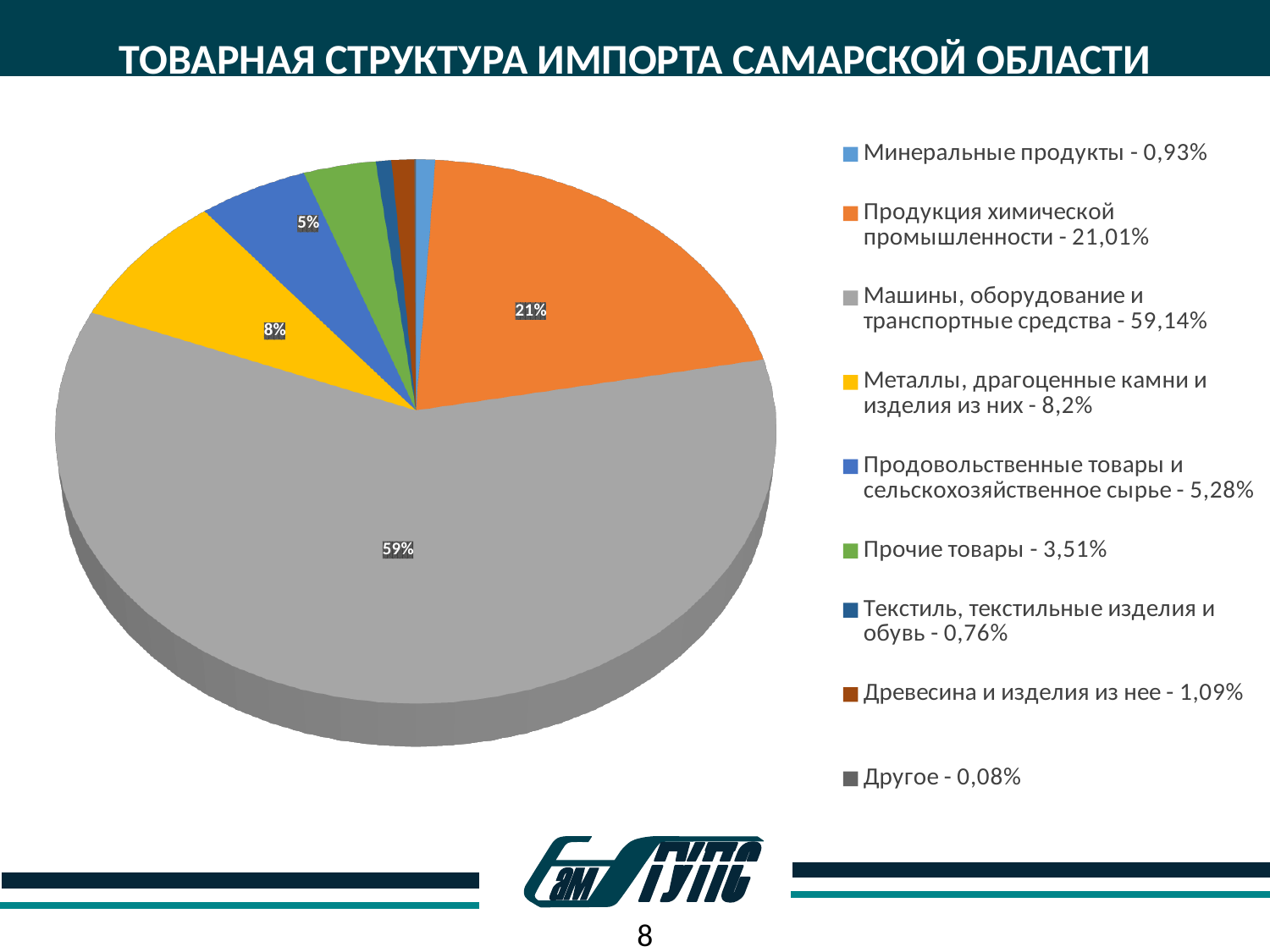
What share of imports does the legend give for Древесина и изделия из нее? 1,09% Which category has the smallest share of imports according to the legend? Другое What share of imports does the legend give for Металлы, драгоценные камни и изделия из них? 8,2% What data label is printed on the largest slice of the pie? 59% By how many percentage points does the share of Машины, оборудование и транспортные средства exceed that of Продукция химической промышленности, using the legend values? 38,13% What is the title of the slide containing the pie chart? ТОВАРНАЯ СТРУКТУРА ИМПОРТА САМАРСКОЙ ОБЛАСТИ Which category has the largest share of imports in the pie chart? Машины, оборудование и транспортные средства How many categories does the legend of the pie chart list? 9 Which has the larger share: Минеральные продукты or Текстиль, текстильные изделия и обувь? Минеральные продукты What kind of chart is shown on the slide? pie chart What share of imports does the legend give for Продукция химической промышленности? 21,01% Which has the larger share: Продовольственные товары и сельскохозяйственное сырье or Прочие товары? Продовольственные товары и сельскохозяйственное сырье